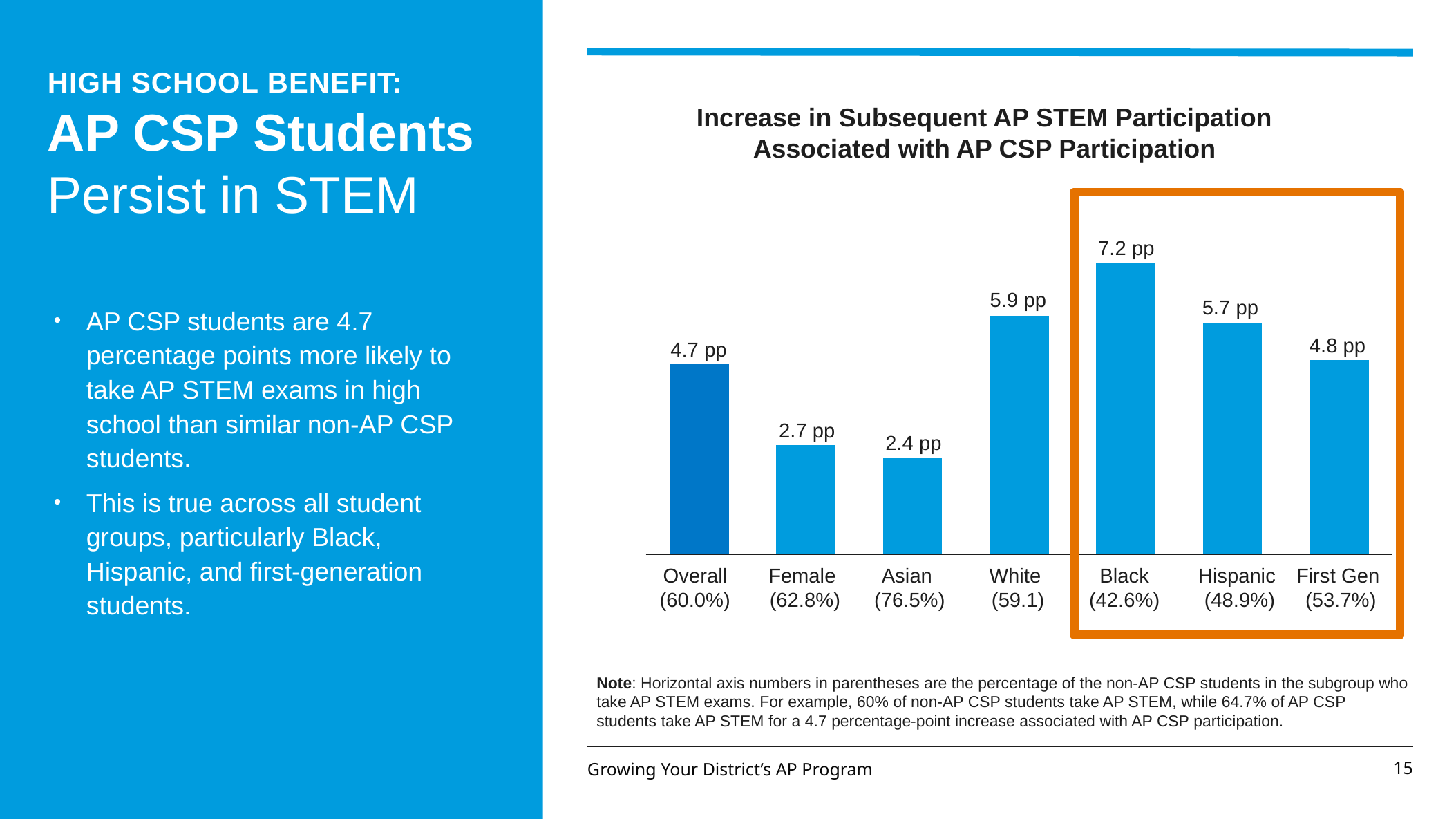
What is the value for Hispanic in the chart? 5.7 pp What is the difference between the values for White and Asian? 3.5 pp Which category has the lowest value in the chart? Asian Which is larger, the value for White or the value for First Gen? White What is the value for Female in the chart? 2.7 pp Which category has the highest value in the chart? Black What kind of chart is shown on the slide? Bar chart What is the title of the chart? Increase in Subsequent AP STEM Participation Associated with AP CSP Participation Which three categories are enclosed by the orange box in the chart? Black, Hispanic, First Gen What is the value for Black in the chart? 7.2 pp How many categories are shown on the x axis of the chart? 7 What is the difference between the values for Black and Overall? 2.5 pp